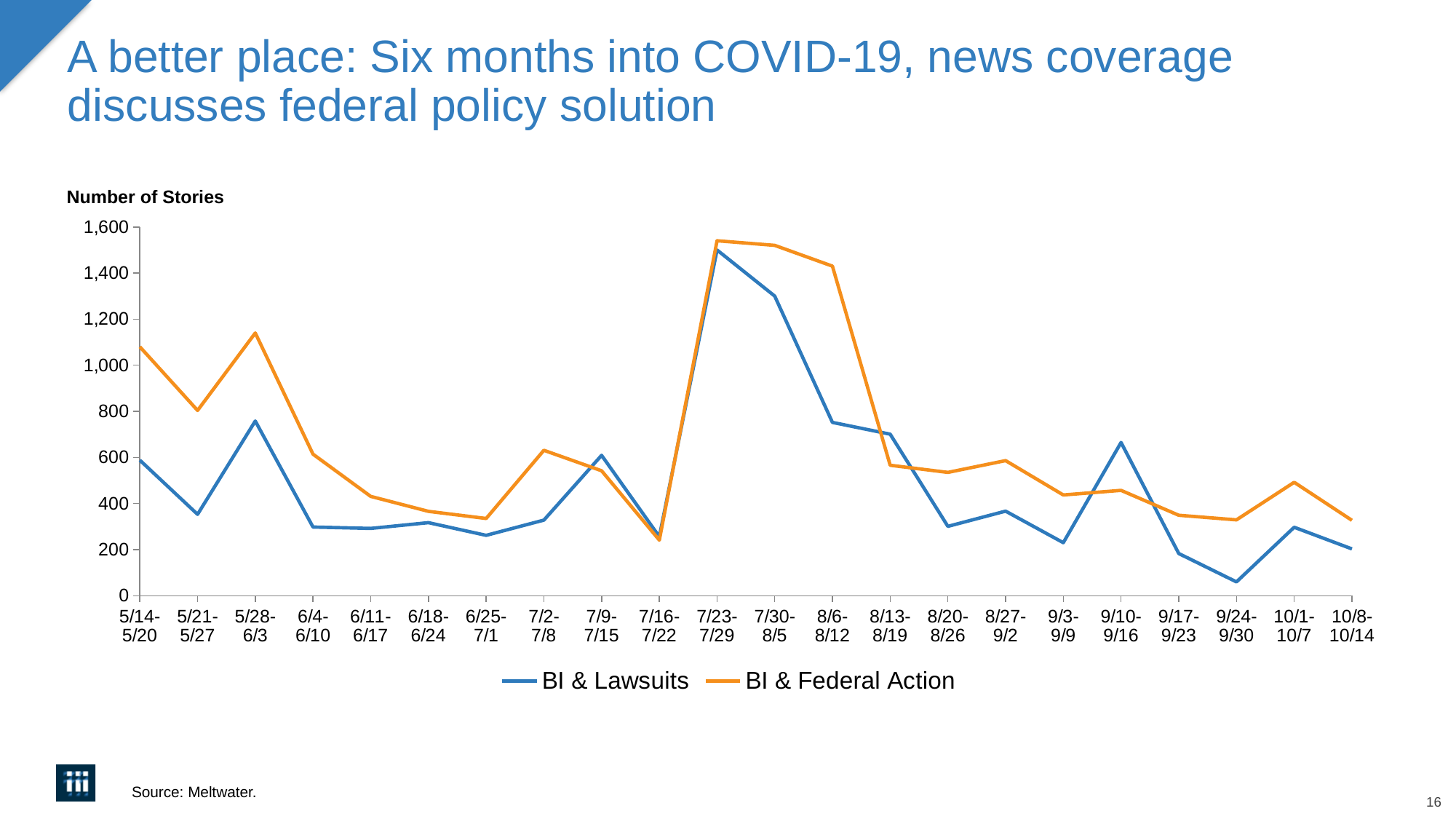
What kind of chart is shown on the slide? Line chart In which period does BI & Lawsuits reach its highest number of stories? 7/23-7/29 In which period does BI & Federal Action reach its highest number of stories? 7/23-7/29 Is the value for BI & Federal Action in 5/14-5/20 greater or less than 1,000? greater Is the value for BI & Lawsuits in 5/28-6/3 greater or less than 800? less Does the number of stories for BI & Lawsuits rise or fall from 7/23-7/29 to 8/6-8/12? Fall In which period is BI & Lawsuits at its lowest? 9/24-9/30 How many series does the legend list? 2 Is the value for BI & Lawsuits in 7/30-8/5 greater or less than 1,200? greater In 9/10-9/16, which series has more stories, BI & Lawsuits or BI & Federal Action? BI & Lawsuits In which period is BI & Federal Action at its lowest? 7/16-7/22 How many weekly periods are shown on the x axis? 22